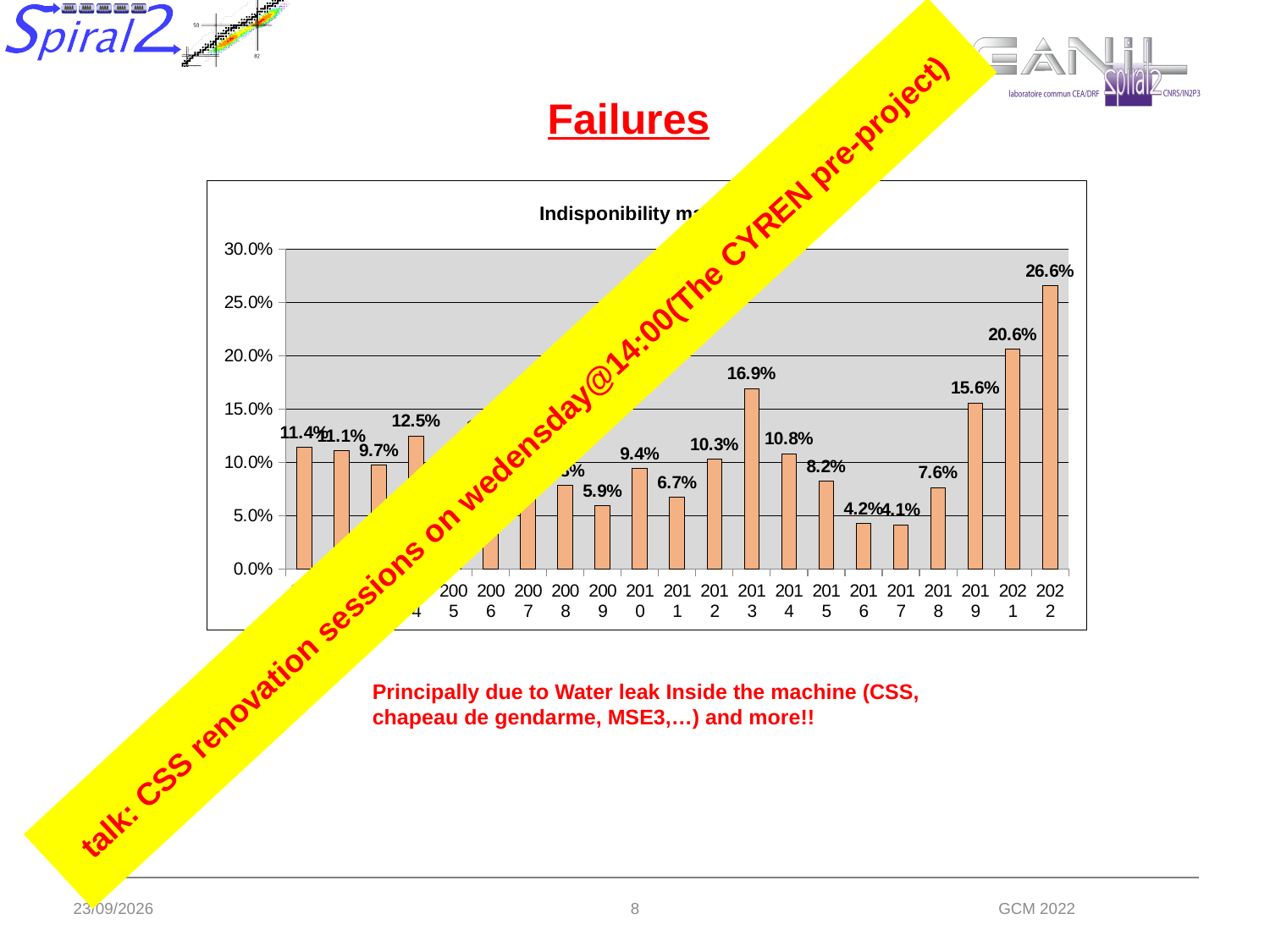
What is the difference between the values for 2022 and 2021? 6.0% What is the difference between the values for 2013 and 2012? 6.6% What is the value for 2013? 16.9% What is the value for 2021? 20.6% Which year has the highest value? 2022 Which is larger, the value for 2013 or the value for 2014? 2013 What is the value for 2019? 15.6% What kind of chart is shown on the slide? bar chart What is the value for 2022? 26.6% Do the values rise or fall from 2017 to 2022? rise What is the value for 2010? 9.4% What is the value for 2016? 4.2%